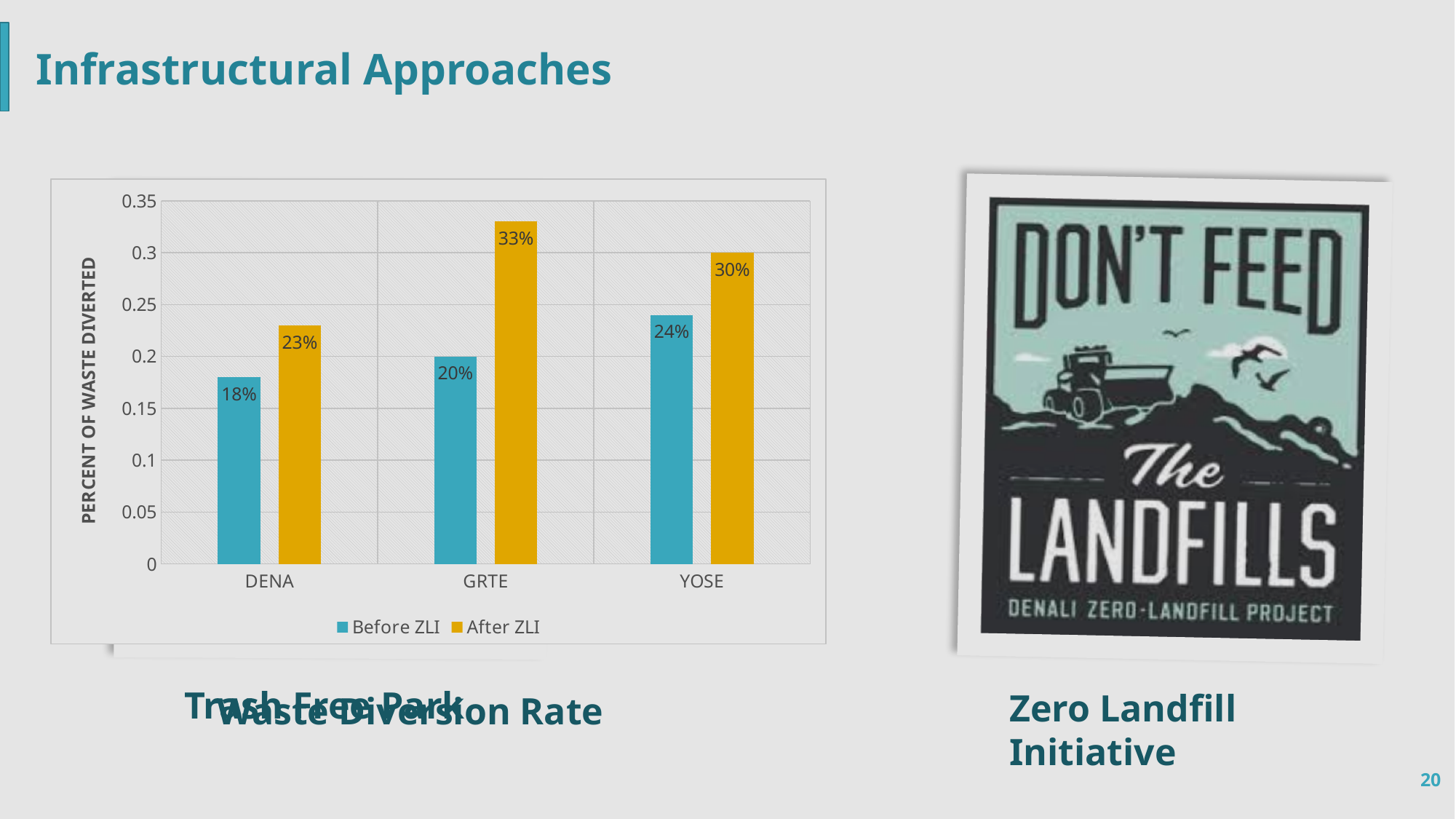
What kind of chart is shown on the slide? Bar chart What is the difference between the After ZLI values for GRTE and DENA? 10% Which park has the lowest Before ZLI value? DENA How many parks are shown on the x axis? 3 What is the After ZLI value for GRTE? 33% What is the label on the vertical axis of the chart? PERCENT OF WASTE DIVERTED Which is larger, the Before ZLI value for YOSE or the Before ZLI value for GRTE? YOSE How many series does the legend list? 2 What is the Before ZLI value for DENA? 18% Which park has the highest After ZLI value? GRTE What is the After ZLI value for YOSE? 30% What is the difference between the After ZLI and Before ZLI values for GRTE? 13%